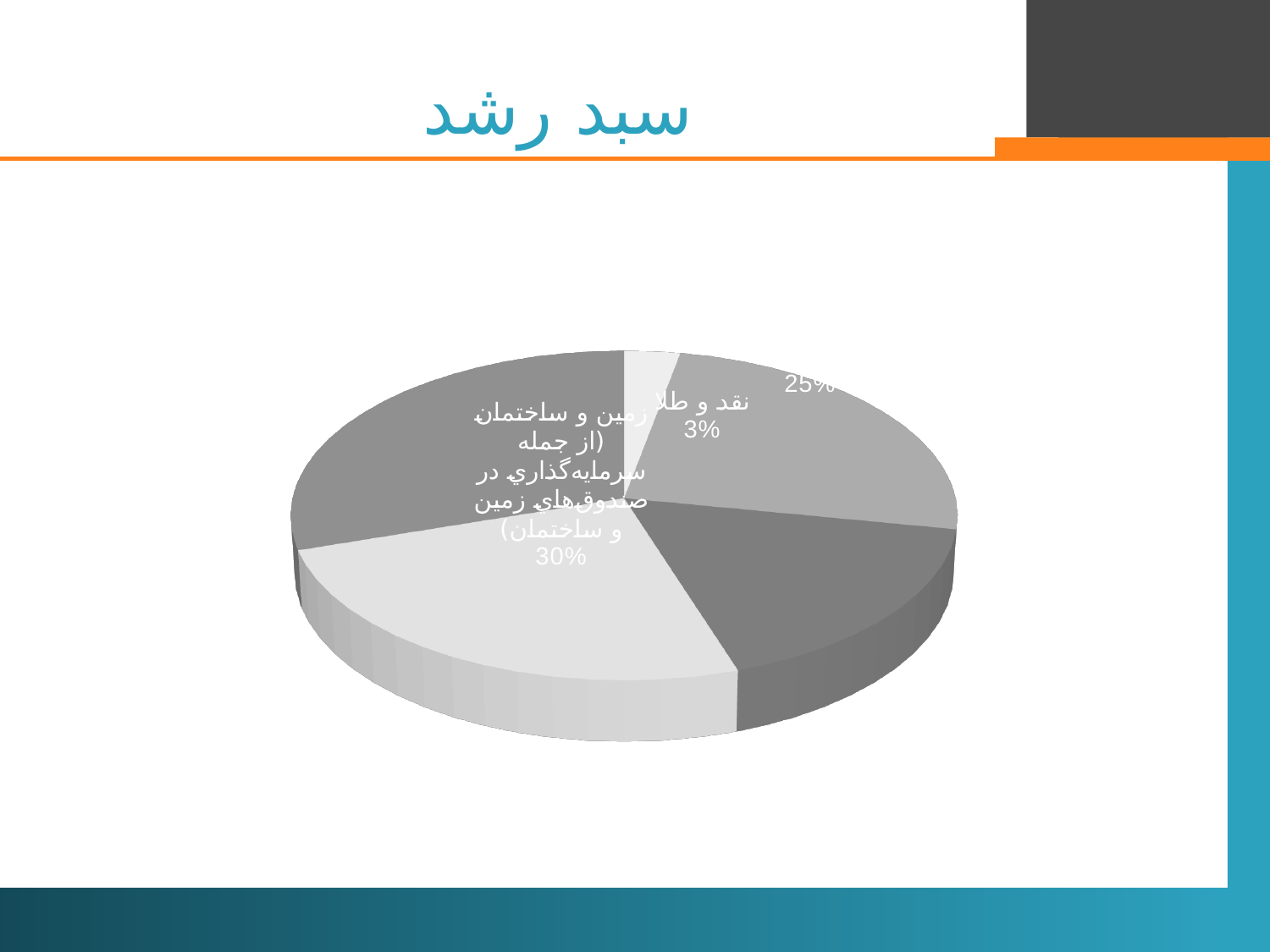
What is the title of the chart on the slide? سبد رشد Which slice of the pie is the smallest? نقد و طلا By how many percentage points does زمین و ساختمان exceed نقد و طلا? 27 percentage points What kind of chart is shown on the slide? pie chart What share of the pie does نقد و طلا represent? 3% Which is larger, the slice for زمین و ساختمان or the slice for نقد و طلا? زمین و ساختمان What percentage is shown for نقد و طلا? 3% What percentage is shown for زمین و ساختمان (از جمله سرمایه‌گذاری در صندوق‌های زمین و ساختمان)? 30% How many slices does the pie chart have? 5